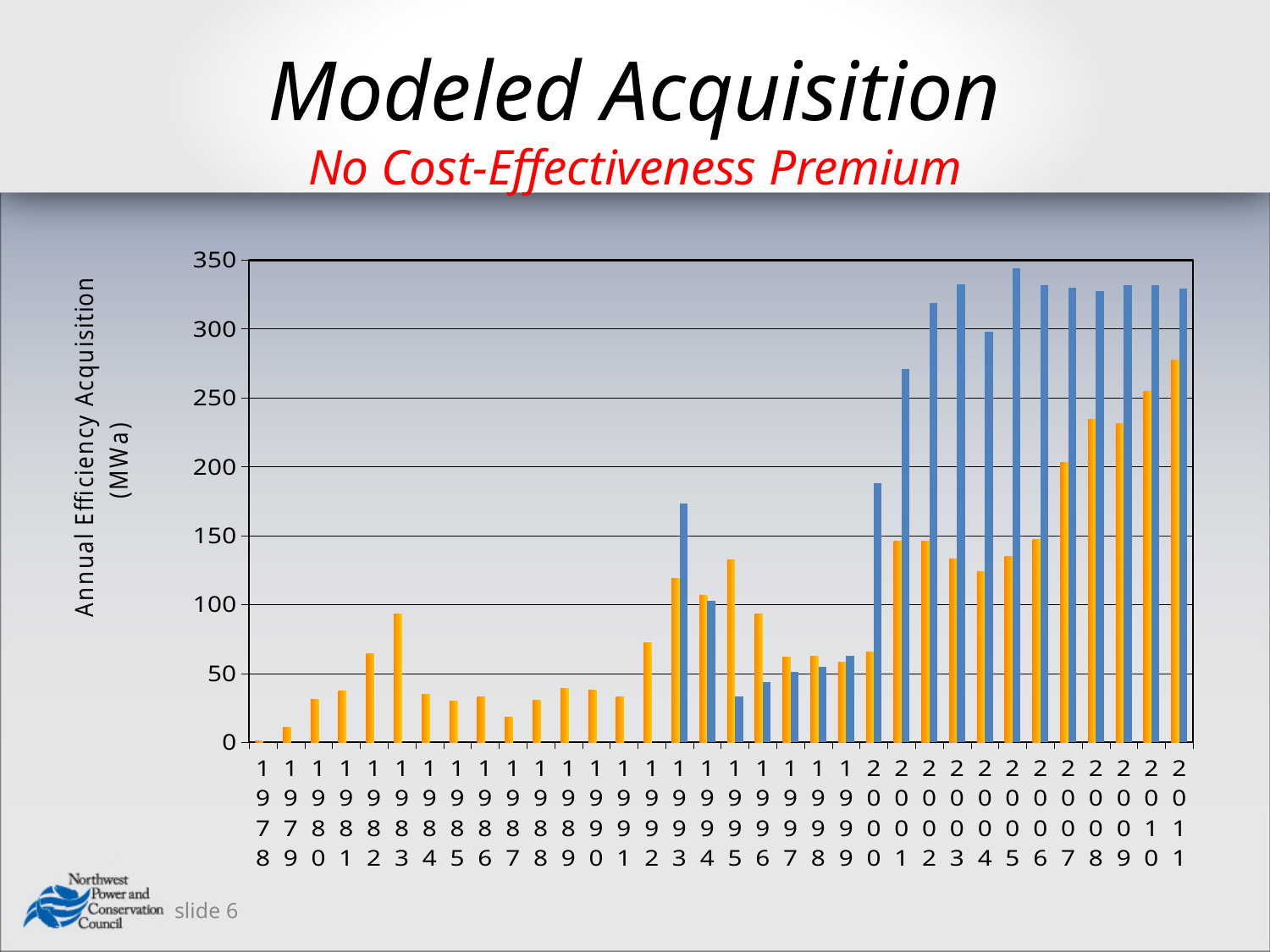
In which year is the orange bar the tallest? 2011 Is the value of the orange bar for 2011 greater or less than 250? greater What is the title of the chart's vertical axis? Annual Efficiency Acquisition (MWa) What is the main title of the slide containing the chart? Modeled Acquisition How many years are shown along the x axis of the chart? 34 Is the value of the blue bar for 2005 greater or less than 300? greater Is the value of the orange bar for 1983 greater or less than 100? less For 1993, which bar is taller, the blue bar or the orange bar? blue bar For 1995, which bar is taller, the orange bar or the blue bar? orange bar In which year is the blue bar the shortest? 1995 What kind of chart is shown on the slide? bar chart